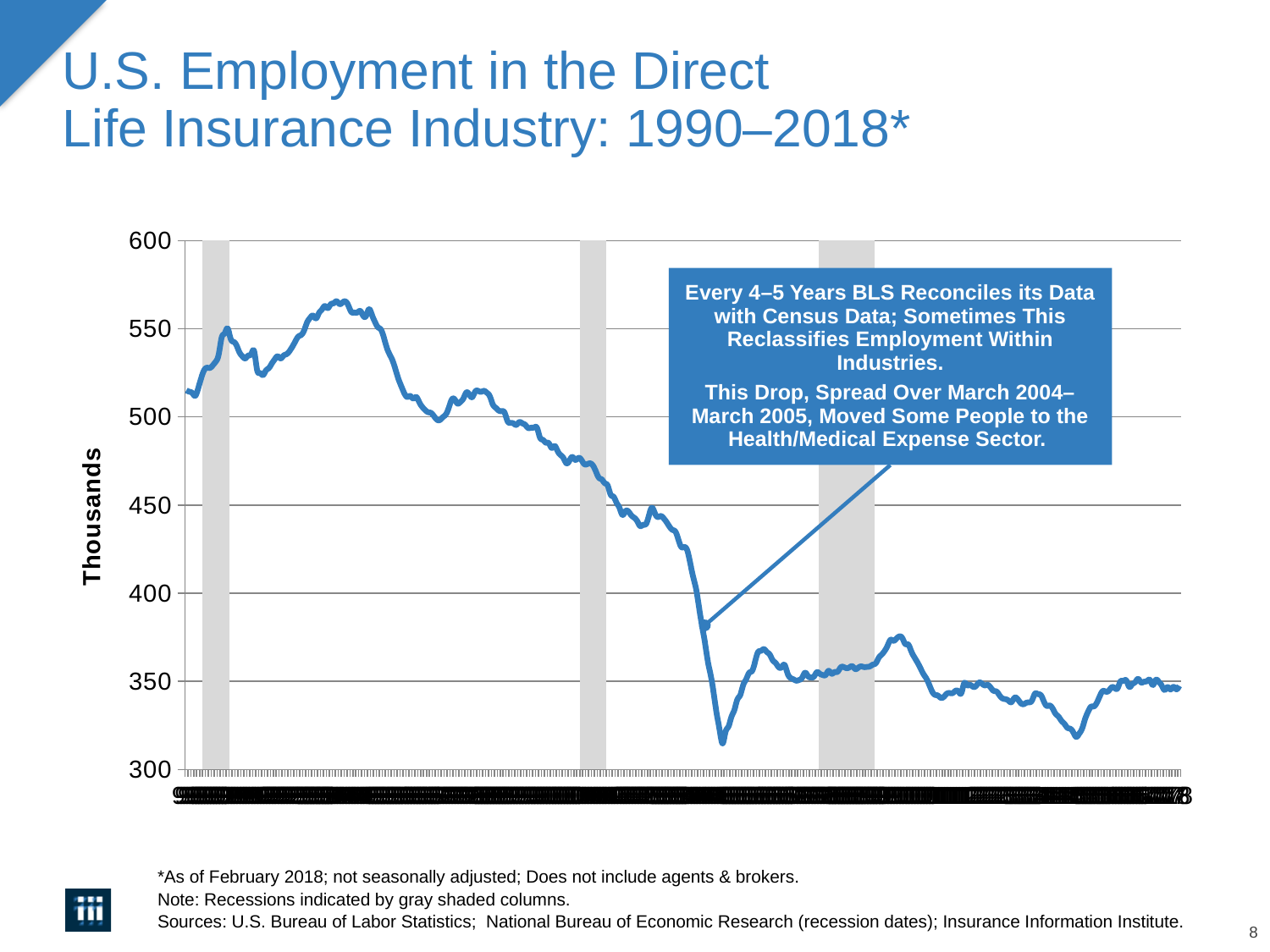
What is the highest value shown on the vertical axis? 600 What is the lowest value shown on the vertical axis? 300 What is the label on the vertical axis of the chart? Thousands Overall, does employment rise or fall from the start of the series to the end? fall What kind of chart is shown on the slide? line chart Is the value at the start of the series greater or less than the value at the end of the series? greater Is the lowest value reached by the line greater or less than 350? less Is the highest value reached by the line greater or less than 550? greater Is the value at the start of the series (1990) greater or less than 500? greater